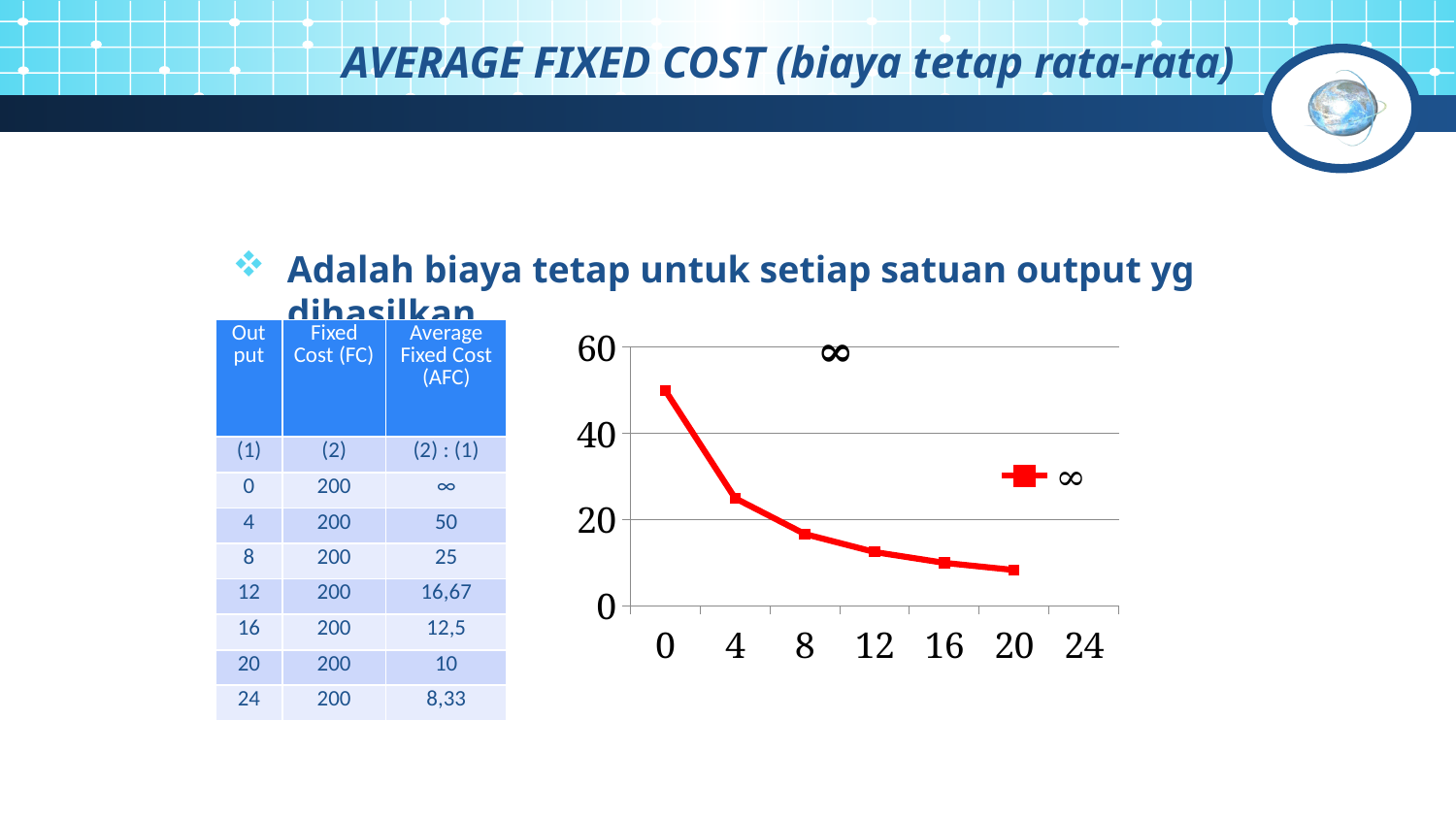
Do the plotted values rise or fall as you move from left to right along the x axis? fall Which has the larger plotted value, x = 4 or x = 12? x = 4 Is the plotted value at x = 8 greater or less than 20? less At which x-axis label is the plotted value highest? 0 Is the plotted value at x = 0 greater or less than 40? greater Is the plotted value at x = 4 greater or less than 40? less At which x-axis label is the plotted value lowest? 20 What is the title shown above the chart? ∞ How many data points are plotted on the line in the chart? 6 What kind of chart is shown on the slide? line chart What colour is the plotted line in the chart? red How many series does the chart legend list? 1